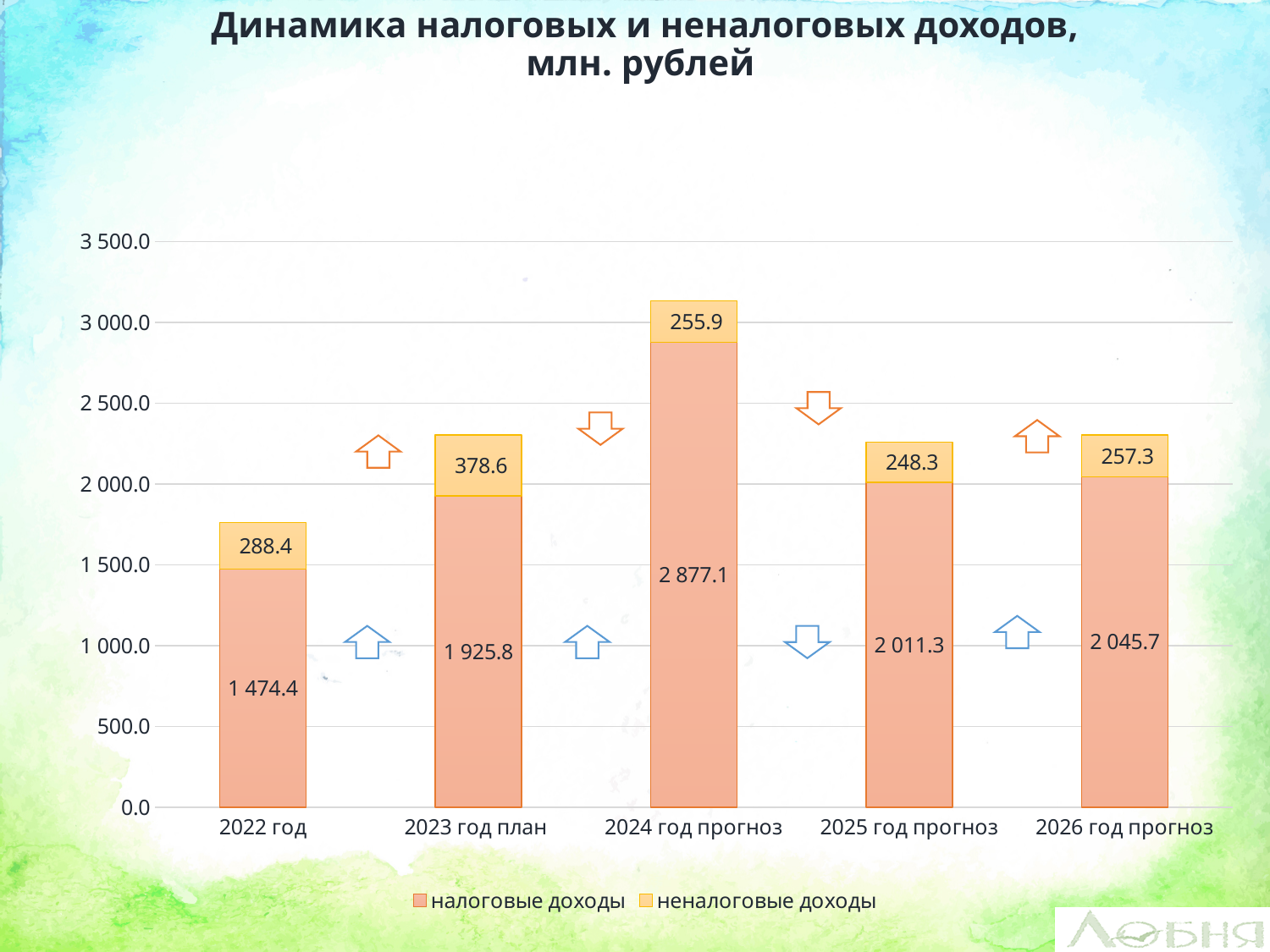
What is the value of неналоговые доходы for 2023 год план? 378.6 What is the difference between налоговые доходы in 2026 год прогноз and 2025 год прогноз? 34.4 How many series does the legend list? 2 How many categories (years) are shown on the x axis? 5 Which year has the lowest value of неналоговые доходы? 2025 год прогноз What is the total of the stacked bar for 2024 год прогноз? 3 133.0 Which year has the highest value of налоговые доходы? 2024 год прогноз What is the title of the chart? Динамика налоговых и неналоговых доходов, млн. рублей What is the value of налоговые доходы for 2022 год? 1 474.4 What type of chart is shown on the slide? Stacked bar chart Which is larger: неналоговые доходы in 2022 год or in 2026 год прогноз? 2022 год What is the value of налоговые доходы for 2024 год прогноз? 2 877.1